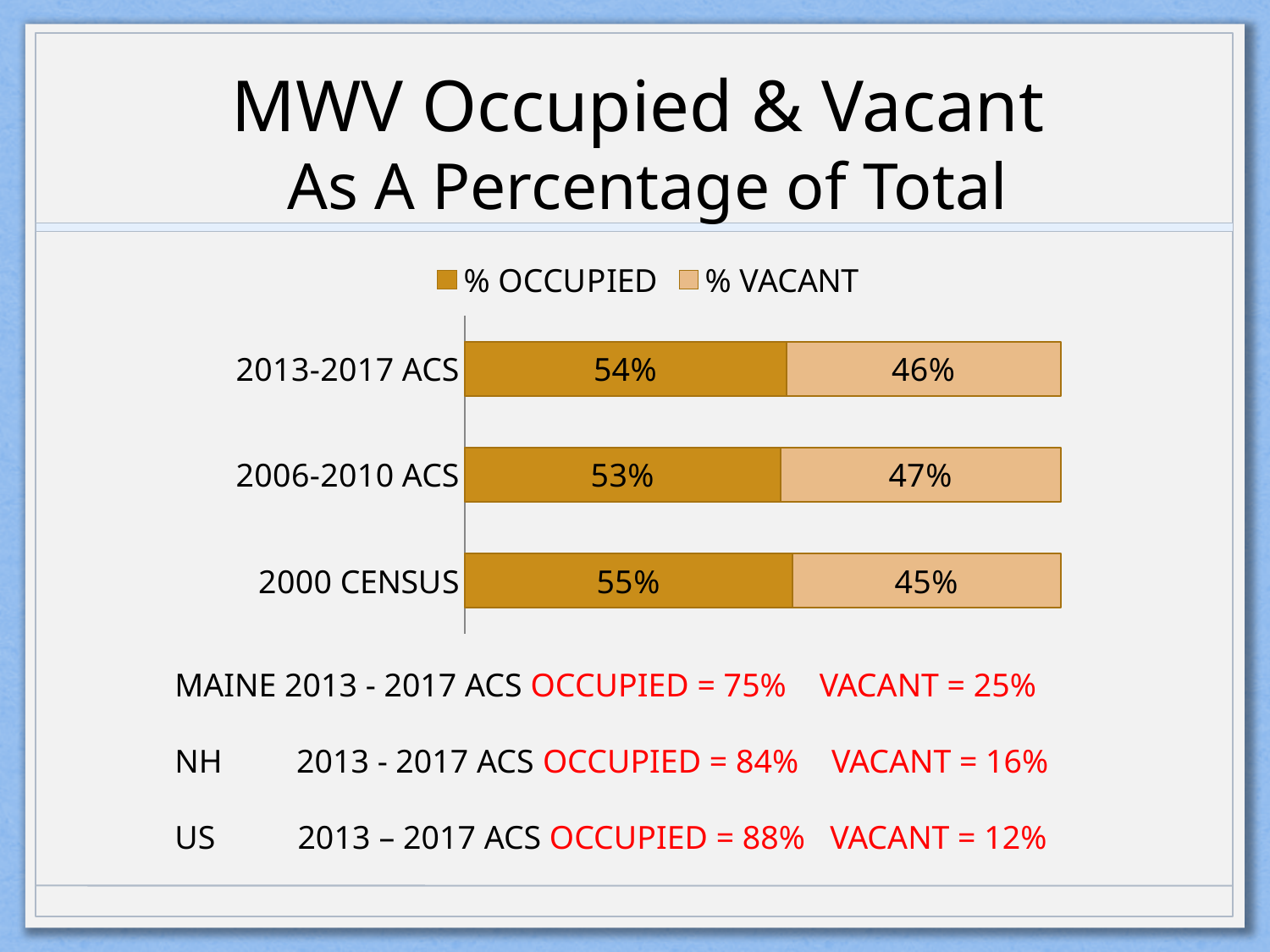
What is the % VACANT value for 2006-2010 ACS? 47% What is the % OCCUPIED value for 2000 CENSUS? 55% What is the total of the stacked bar for 2000 CENSUS? 100% How many series does the legend list? 2 Is the % OCCUPIED value for 2013-2017 ACS larger or smaller than the % OCCUPIED value for 2000 CENSUS? smaller Which category has the highest % OCCUPIED value? 2000 CENSUS What kind of chart is shown on the slide? stacked bar chart What is the difference between the % OCCUPIED and % VACANT values for 2006-2010 ACS? 6% How many categories are shown on the chart? 3 What is the % OCCUPIED value for 2013-2017 ACS? 54% What is the % VACANT value for 2013-2017 ACS? 46% Which category has the lowest % VACANT value? 2000 CENSUS